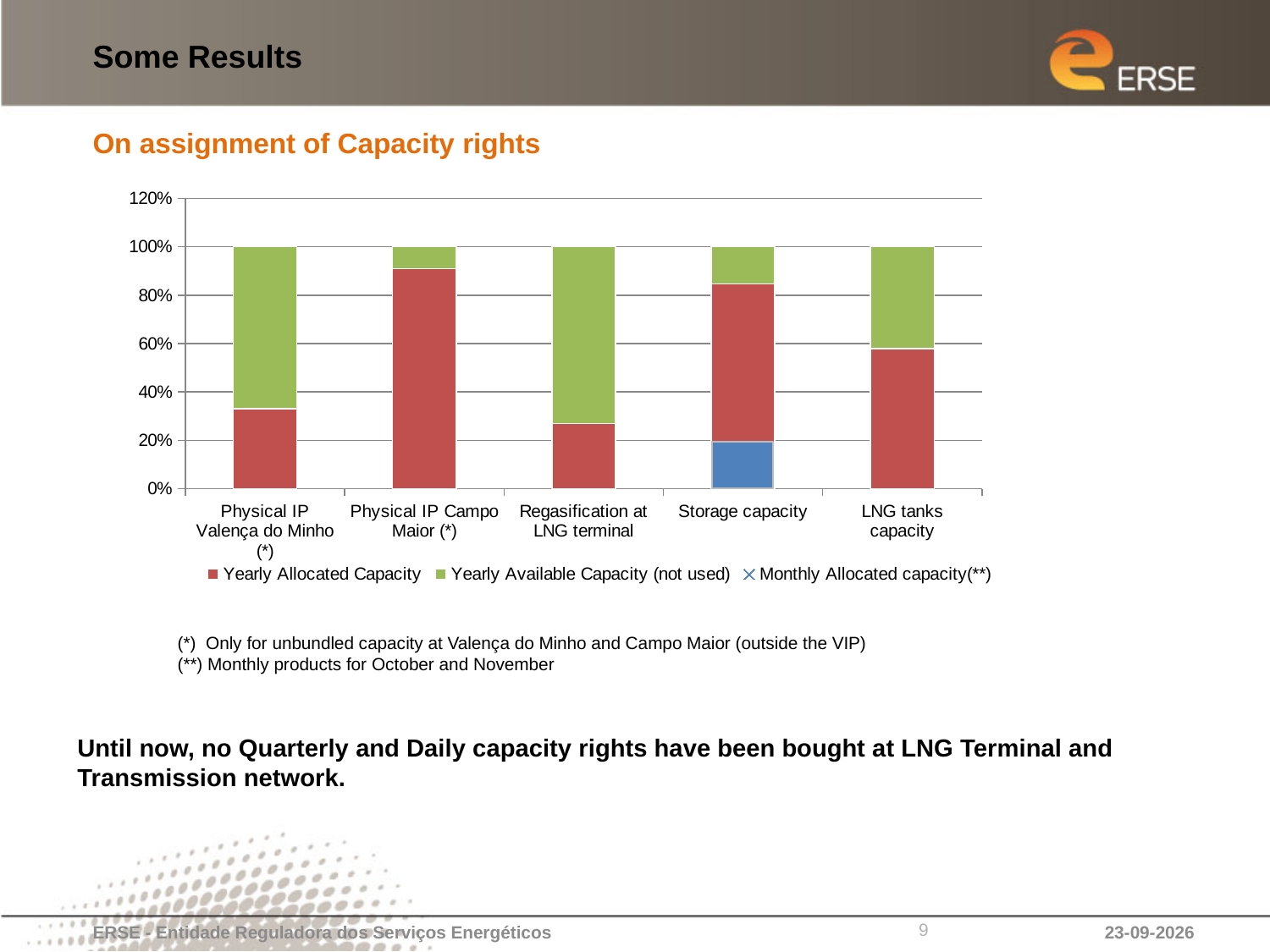
How many categories are shown along the x axis of the chart? 5 What kind of chart is shown on the slide? bar chart What is the total height of the stacked bar for LNG tanks capacity? 100% How many series does the chart's legend list? 3 Is the Yearly Allocated Capacity for Physical IP Valença do Minho (*) greater or less than 40%? less Which category has the highest Yearly Allocated Capacity? Physical IP Campo Maior (*) Which category has the lowest Yearly Allocated Capacity? Regasification at LNG terminal Which category shows a Monthly Allocated capacity(**) value in the chart? Storage capacity Which has the larger Yearly Allocated Capacity, Physical IP Campo Maior (*) or LNG tanks capacity? Physical IP Campo Maior (*) Is the Yearly Allocated Capacity for Regasification at LNG terminal greater or less than 40%? less Is the Yearly Allocated Capacity for Physical IP Campo Maior (*) greater or less than 80%? greater